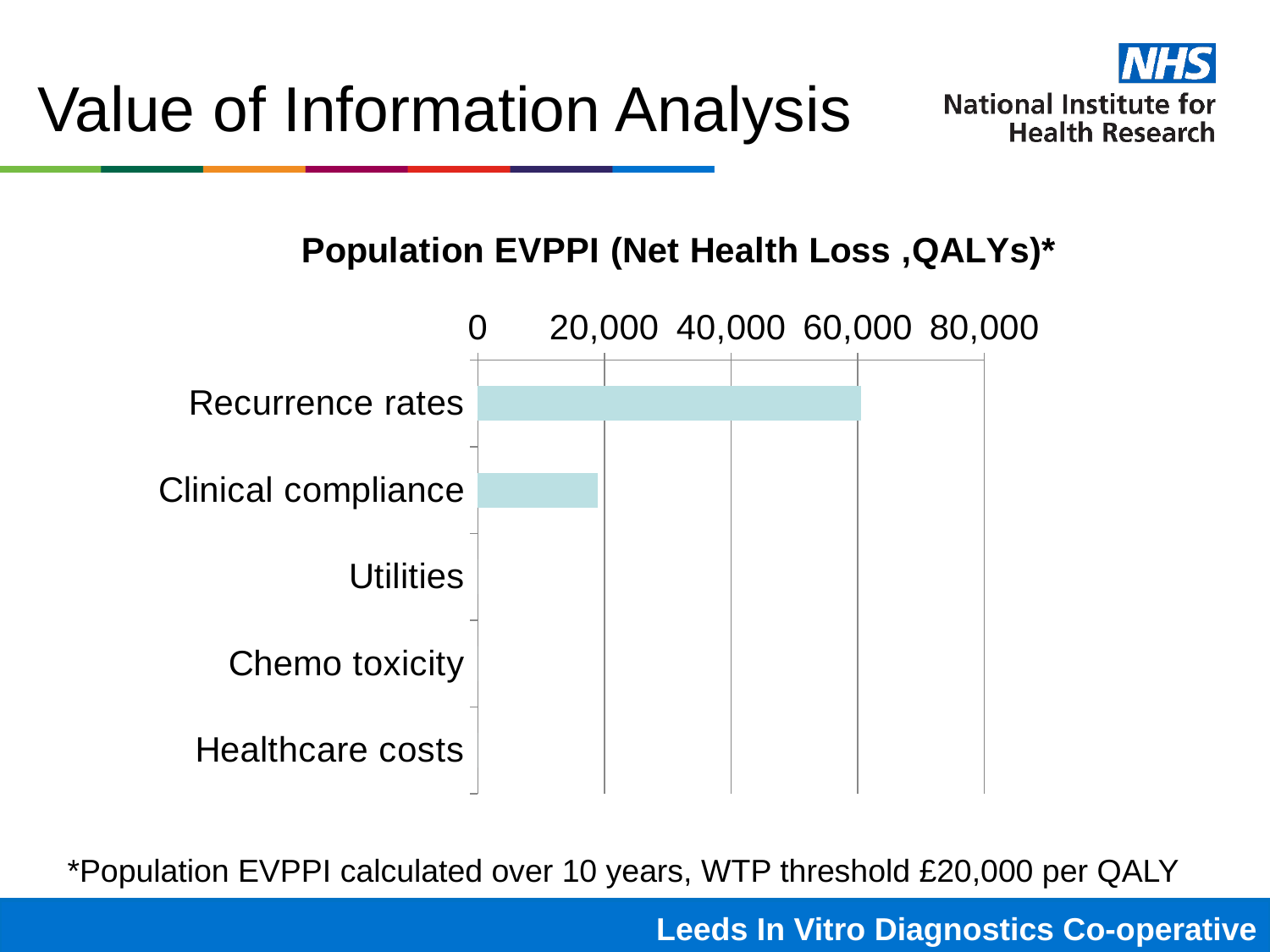
How many categories are plotted in the chart? 5 Which is larger, the value for Recurrence rates or the value for Clinical compliance? Recurrence rates Is the value for Clinical compliance greater or less than 60,000? less What kind of chart is shown on the slide? bar chart Is the value for Clinical compliance greater or less than 40,000? less What is the highest value shown on the chart's horizontal axis? 80,000 Is the value for Recurrence rates greater or less than 20,000? greater Which category is listed at the bottom of the chart? Healthcare costs What is the title of the chart? Population EVPPI (Net Health Loss ,QALYs)* Which category has the highest Population EVPPI value? Recurrence rates